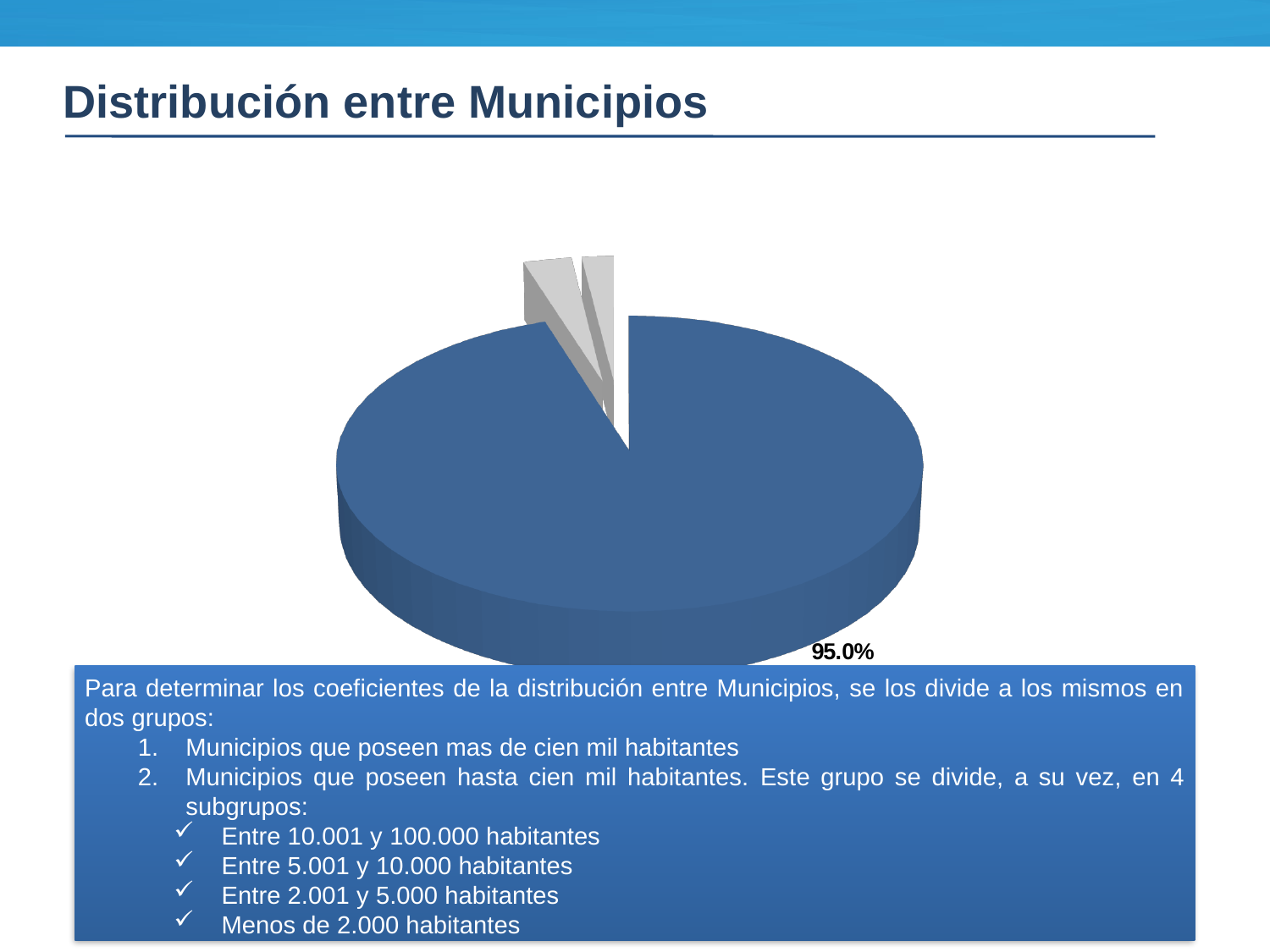
Which slice of the pie chart is the largest, the blue one or one of the grey ones? the blue one What is the title of the chart slide? Distribución entre Municipios What colour is the largest slice of the pie chart? blue What percentage is printed on the large blue slice of the pie chart? 95.0% What kind of chart is shown on the slide? pie chart What share of the pie does the large blue slice represent? 95.0% How many data labels are printed on the pie chart? 1 Is the share of the large blue slice greater or less than 50%? greater How many slices does the pie chart have? 3